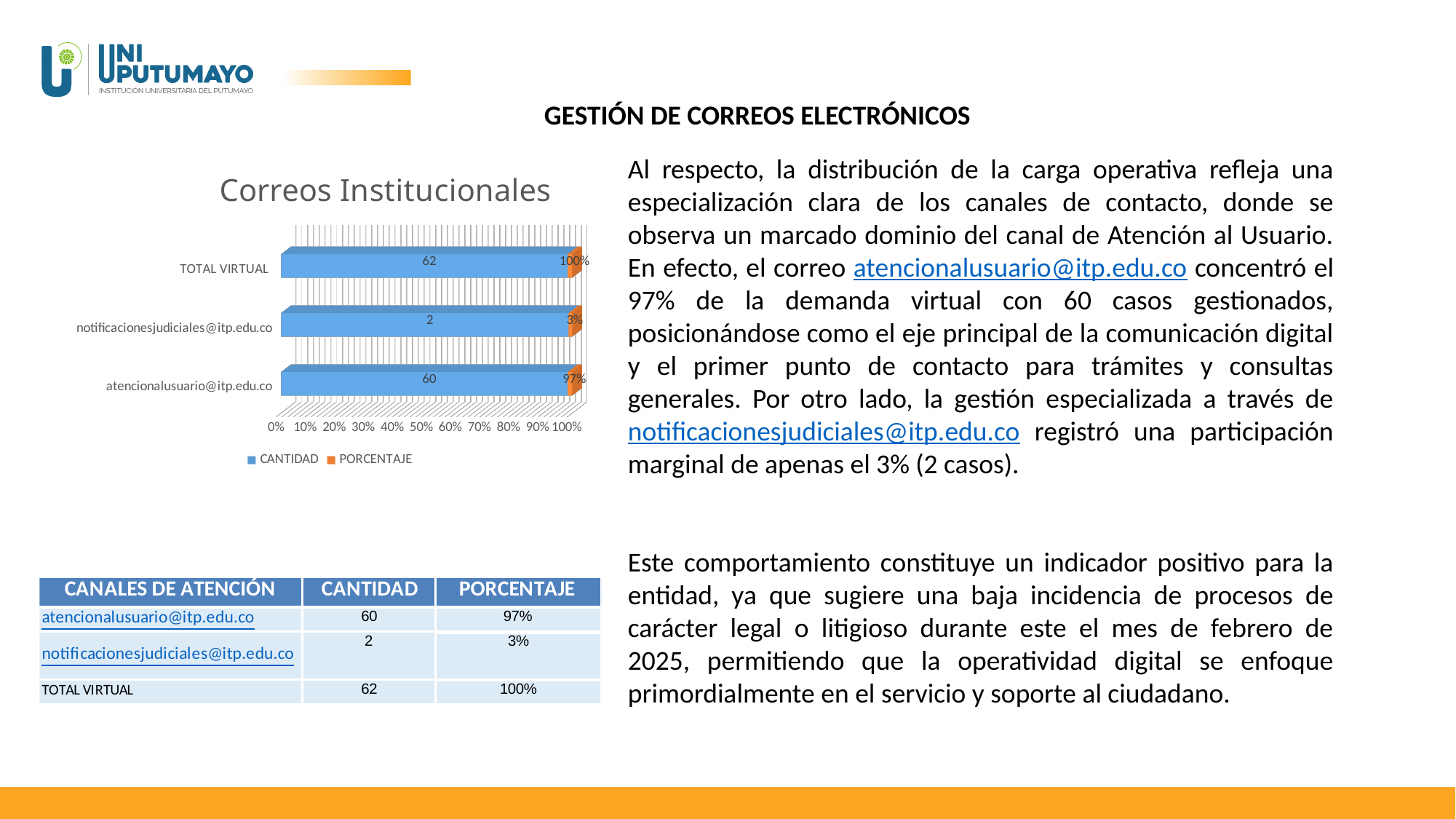
What is the CANTIDAD value for TOTAL VIRTUAL in the Correos Institucionales chart? 62 What PORCENTAJE label is shown for atencionalusuario@itp.edu.co in the Correos Institucionales chart? 97% Which category has the highest PORCENTAJE value in the Correos Institucionales chart? TOTAL VIRTUAL What colour represents the PORCENTAJE series in the Correos Institucionales chart? Orange What PORCENTAJE label is shown for notificacionesjudiciales@itp.edu.co in the Correos Institucionales chart? 3% How many categories are shown in the Correos Institucionales chart? 3 Which category has the lowest CANTIDAD value in the Correos Institucionales chart? notificacionesjudiciales@itp.edu.co What is the CANTIDAD value for atencionalusuario@itp.edu.co in the Correos Institucionales chart? 60 What type of chart is the Correos Institucionales chart? Bar chart What is the difference between the CANTIDAD values for atencionalusuario@itp.edu.co and notificacionesjudiciales@itp.edu.co in the Correos Institucionales chart? 58 Which has a larger CANTIDAD value in the Correos Institucionales chart: atencionalusuario@itp.edu.co or notificacionesjudiciales@itp.edu.co? atencionalusuario@itp.edu.co How many series does the legend of the Correos Institucionales chart list? 2